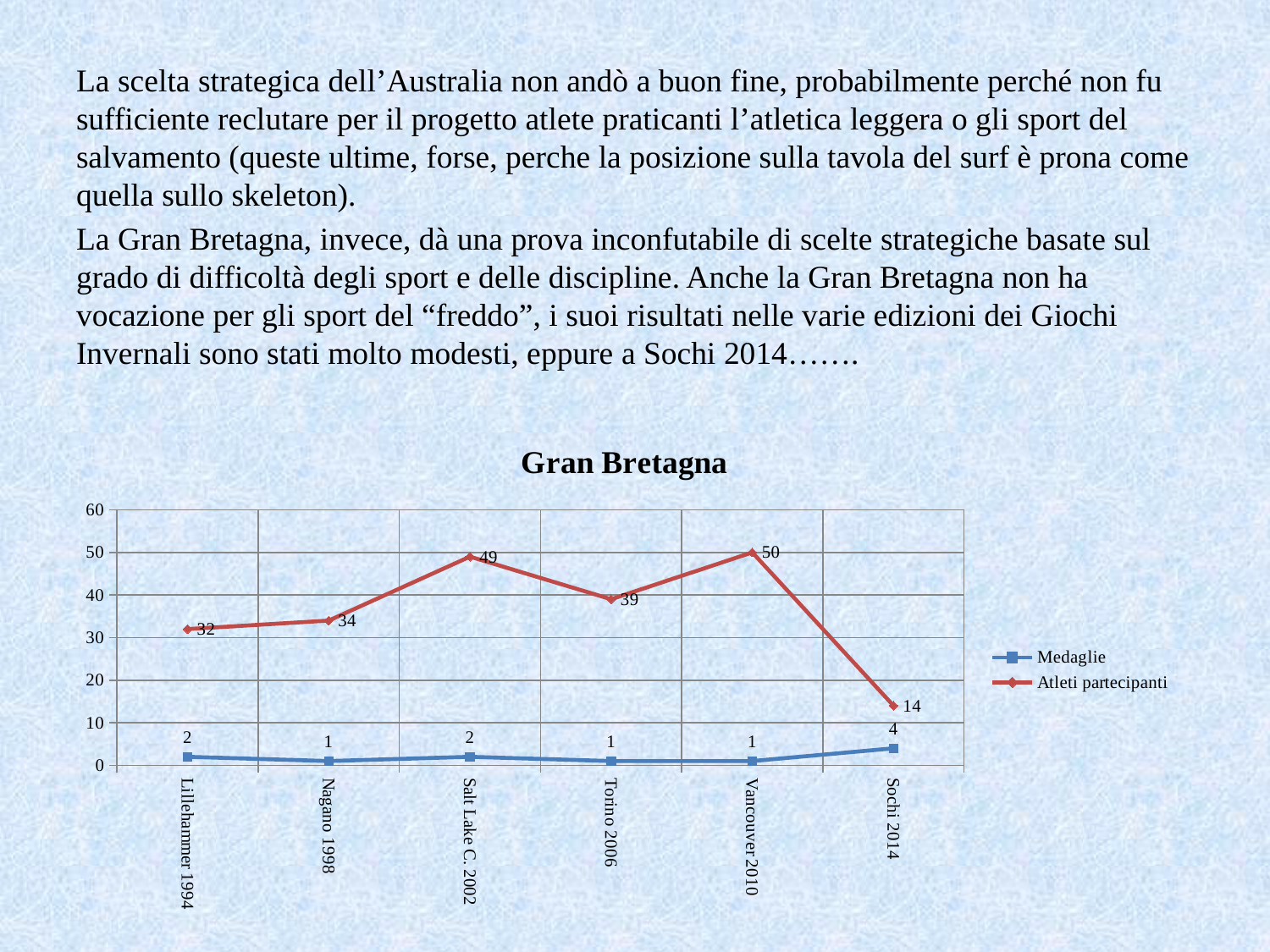
How many Games editions are shown on the x axis? 6 What is the difference in Atleti partecipanti between Vancouver 2010 and Sochi 2014? 36 Does the Atleti partecipanti series rise or fall from Vancouver 2010 to Sochi 2014? Fall What is the value of Atleti partecipanti for Torino 2006? 39 What is the value of Medaglie for Sochi 2014? 4 What is the value of Atleti partecipanti for Salt Lake C. 2002? 49 At which Games edition is Atleti partecipanti highest? Vancouver 2010 Which is larger: Atleti partecipanti at Nagano 1998 or at Torino 2006? Torino 2006 How many series does the legend list? 2 What is the title of the chart? Gran Bretagna At which Games edition is Atleti partecipanti lowest? Sochi 2014 What kind of chart is shown on the slide? Line chart